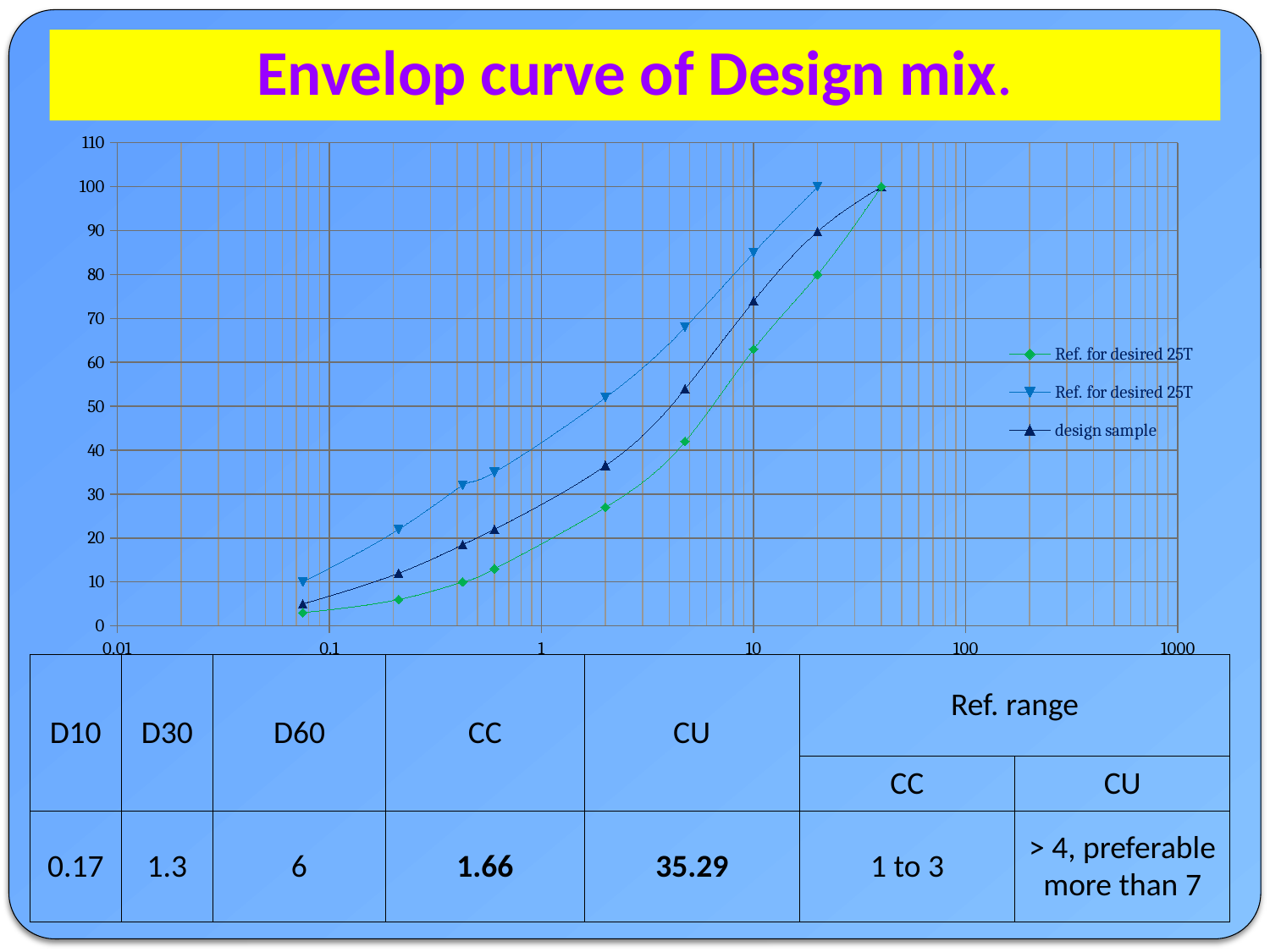
Is the value of the design sample series at its leftmost point (near x = 0.075) greater or less than 10? less What is the name of the third series listed in the legend? design sample At x = 10, which series has the highest value? the blue Ref. for desired 25T series Is the value of the green 'Ref. for desired 25T' series at x = 10 greater or less than 60? greater At x = 2, which series has the lowest value? the green Ref. for desired 25T series What kind of chart is shown on the slide? line chart Is the value of the design sample series at x = 10 greater or less than 70? greater Do the values of the design sample series rise or fall as the x axis increases? rise How many series does the chart legend list? 3 What is the title of the chart on the slide? Envelop curve of Design mix.